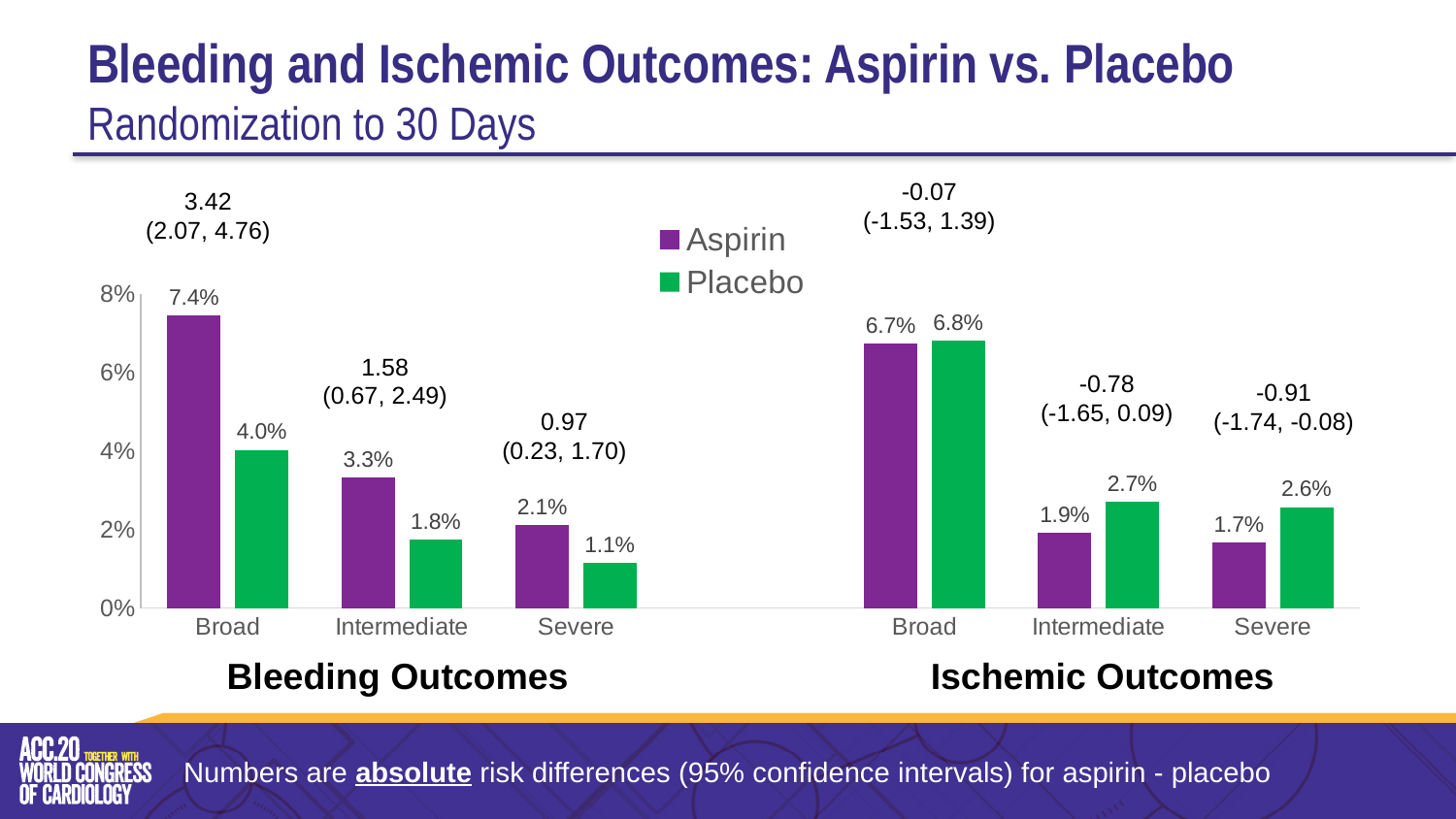
In the Ischemic Outcomes chart, which category has the lowest Aspirin value? Severe In the Bleeding Outcomes chart, which category has the highest Aspirin value? Broad In the Ischemic Outcomes chart, which is larger in the Intermediate category, Aspirin or Placebo? Placebo In the Bleeding Outcomes chart, what is the difference between the Aspirin and Placebo values in the Severe category? 1.0% In the Ischemic Outcomes chart, what is the value for Aspirin in the Intermediate category? 1.9% In the Bleeding Outcomes chart, what is the value for Placebo in the Intermediate category? 1.8% In the Bleeding Outcomes chart, what is the value for Aspirin in the Broad category? 7.4% How many series does the legend list? 2 How many categories are shown on the x axis of the Ischemic Outcomes chart? 3 In the Bleeding Outcomes chart, is the Placebo value for Broad greater or less than 2%? greater In the Ischemic Outcomes chart, what is the value for Placebo in the Severe category? 2.6% What kind of chart is the Bleeding Outcomes chart? Bar chart